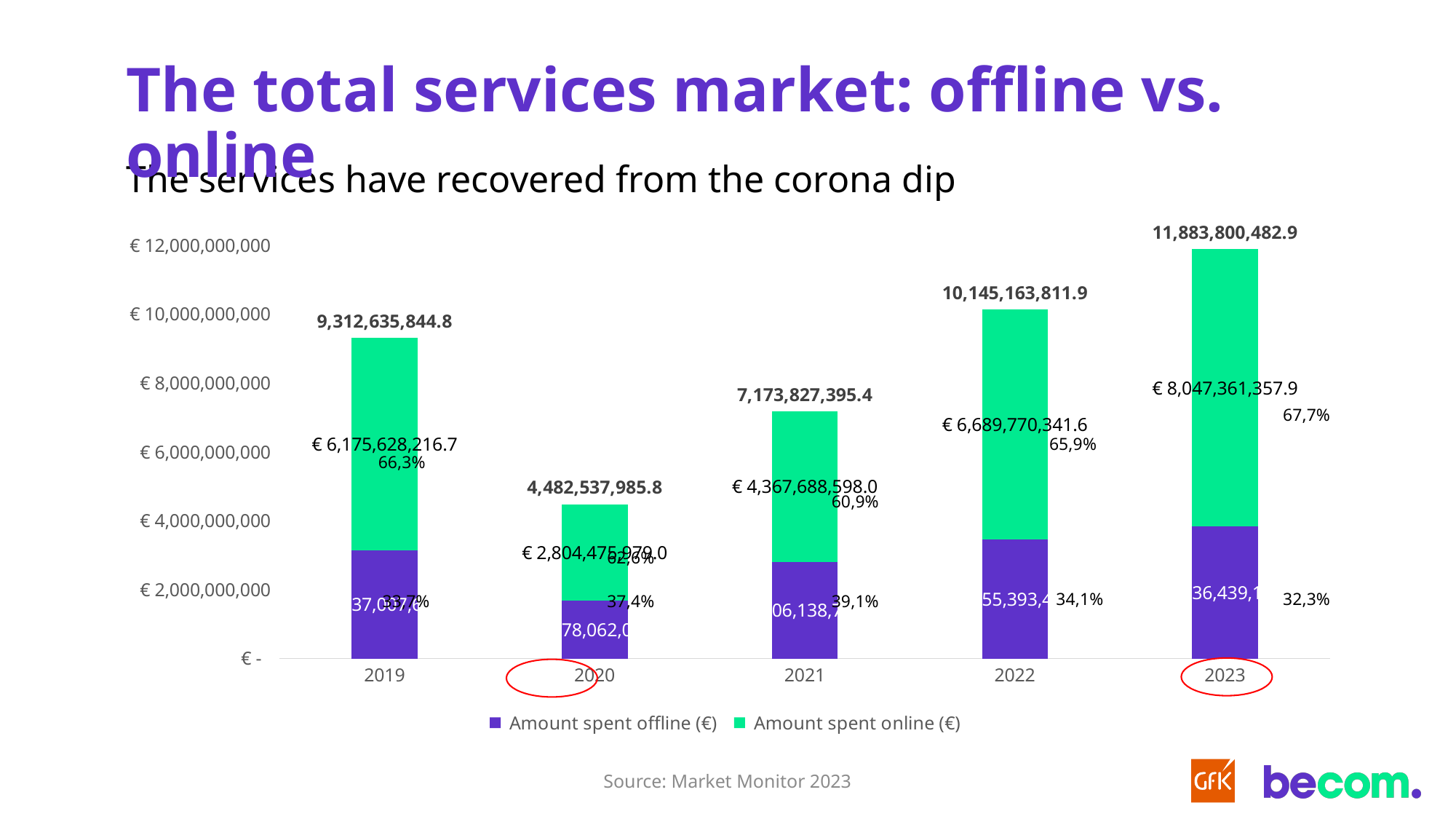
What is the amount spent online in 2023? € 8,047,361,357.9 What is the difference between the total market values for 2023 and 2022? 1,738,636,671.0 What percentage of the 2023 total was spent offline? 32,3% How many series does the legend list? 2 What kind of chart is shown on the slide? Stacked bar chart Is the total market value for 2021 greater or less than € 8,000,000,000? less Which year has the lowest total services market value? 2020 Which year has the highest total services market value? 2023 What is the amount spent online in 2022? € 6,689,770,341.6 What percentage of the 2021 total was spent online? 60,9% What is the total services market value shown above the 2023 bar? 11,883,800,482.9 What is the total services market value shown above the 2020 bar? 4,482,537,985.8